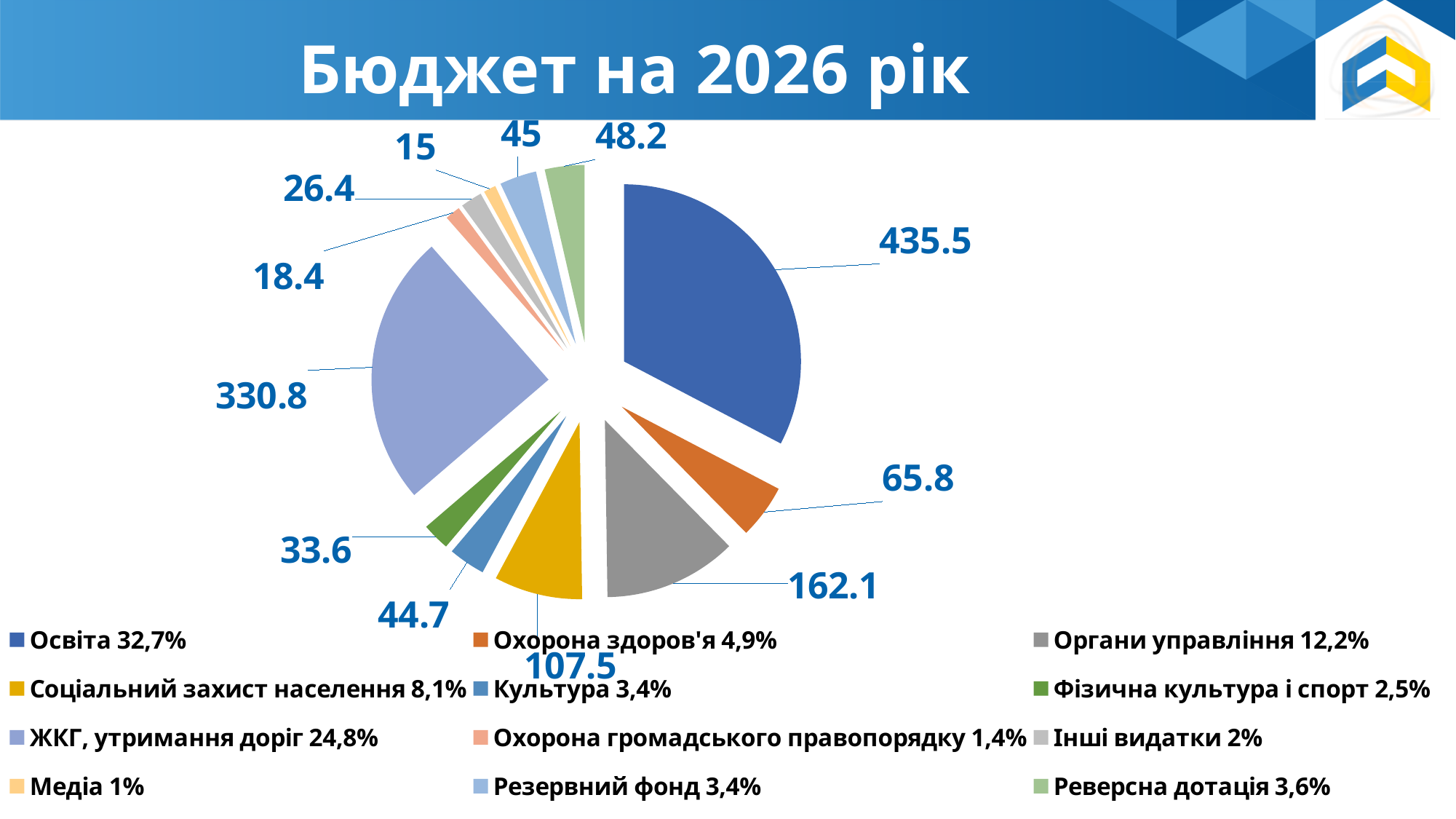
What is the value shown for Органи управління? 162.1 What is the value shown for Медіа? 15 How many slices does the pie chart have? 12 Which is larger, the value for Соціальний захист населення or the value for Охорона здоров'я? Соціальний захист населення What share of the pie does Органи управління represent, according to the legend? 12,2% What type of chart is shown on the slide? pie chart What is the title of the chart? Бюджет на 2026 рік Which category has the largest slice of the pie? Освіта What is the value shown for ЖКГ, утримання доріг? 330.8 Which category has the smallest slice of the pie? Медіа What is the value shown for Освіта? 435.5 What is the difference between the values for Освіта and ЖКГ, утримання доріг? 104.7